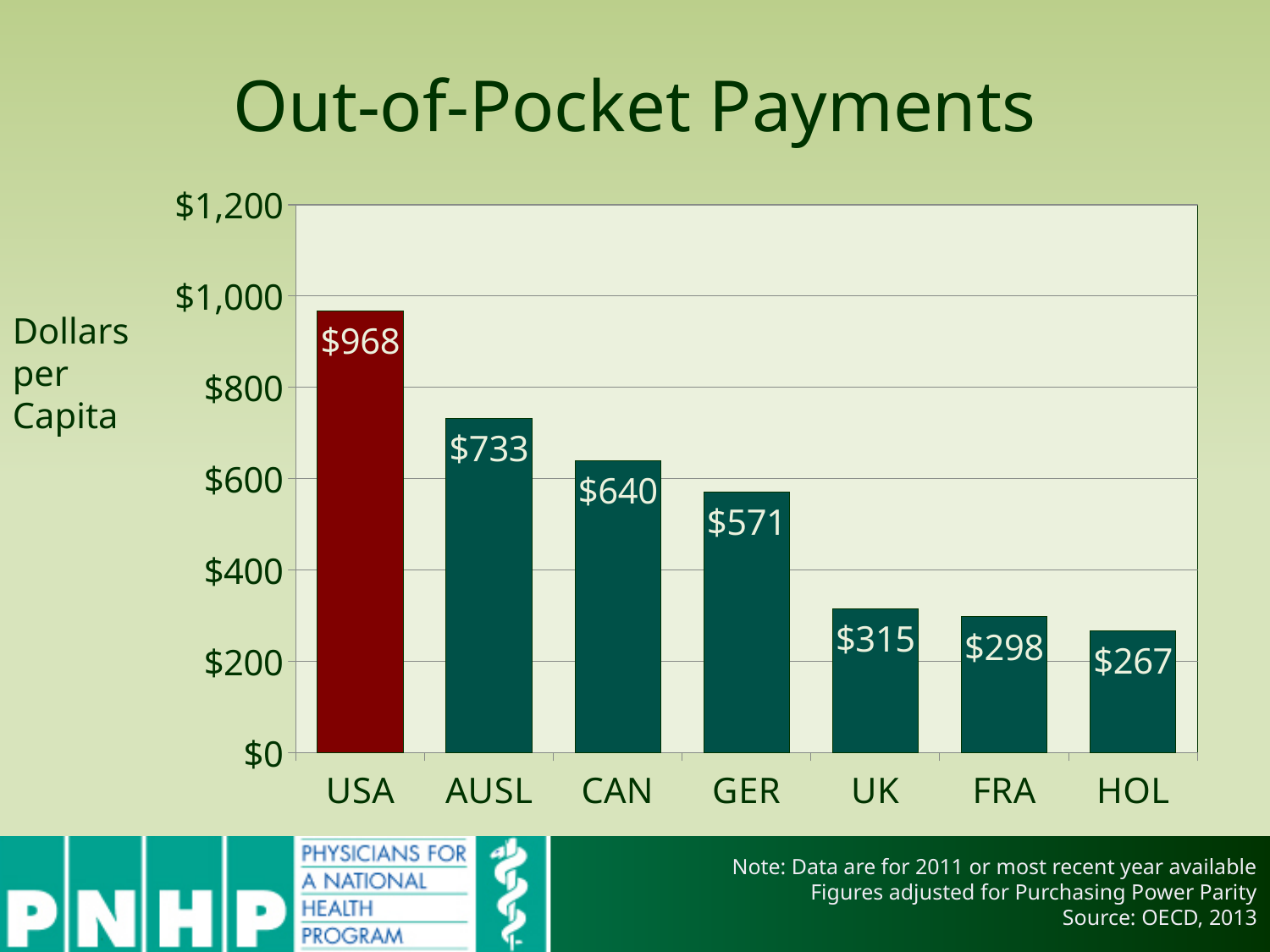
What is the value shown for HOL? $267 What is the out-of-pocket payment per capita for the USA? $968 What is the title of the chart? Out-of-Pocket Payments What kind of chart is shown on the slide? Bar chart What is the difference between the values for CAN and UK? $325 Which country has the highest out-of-pocket payments per capita? USA Is the value for AUSL greater or less than $800? less Which country has the lowest out-of-pocket payments per capita? HOL Which has a higher value, UK or FRA? UK What is the value shown for GER? $571 What is the difference between the values for USA and AUSL? $235 How many countries are shown on the chart? 7